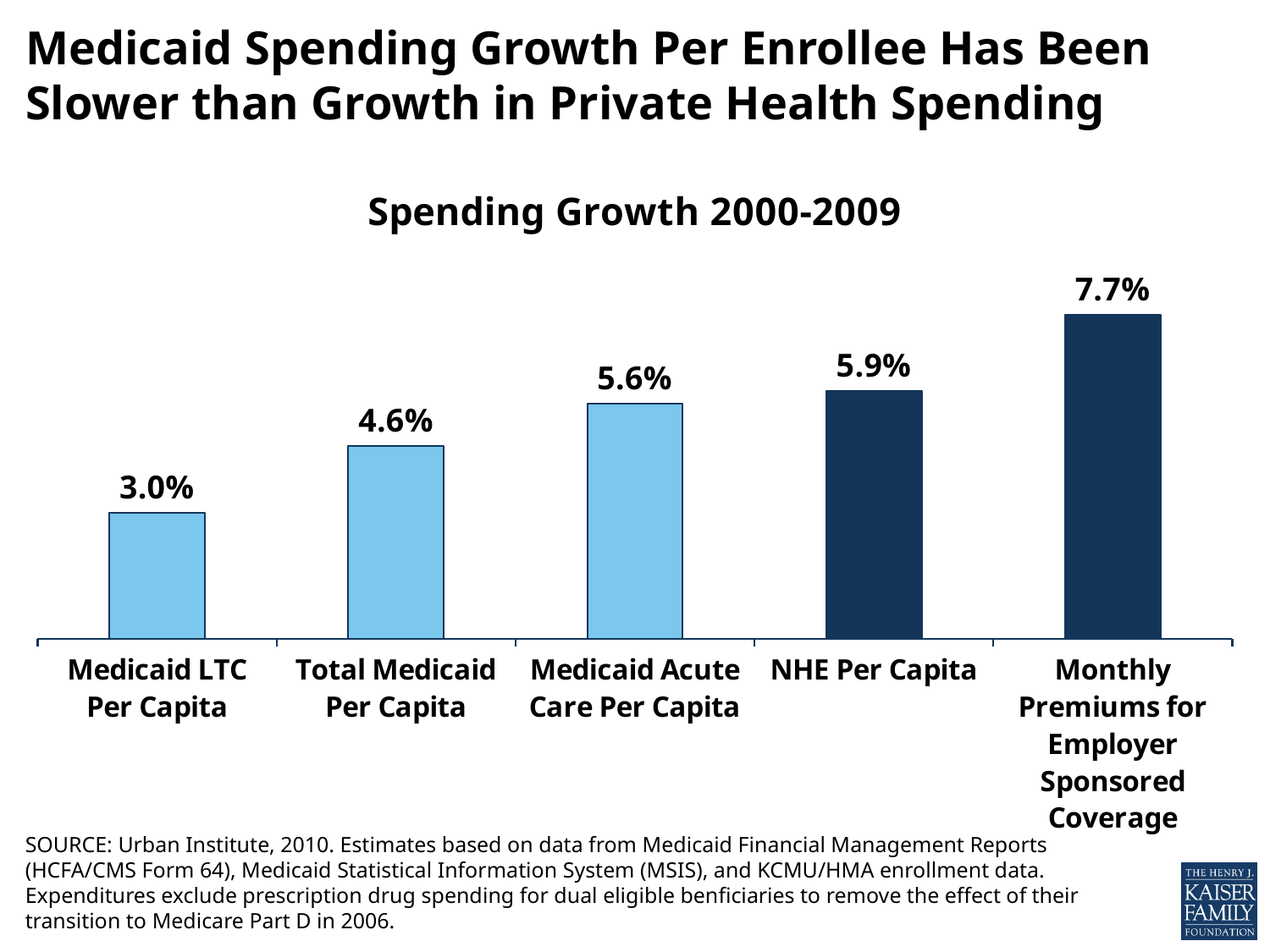
How many categories are shown in the chart? 5 What is the spending growth value for Monthly Premiums for Employer Sponsored Coverage? 7.7% Which is larger, the spending growth for Medicaid Acute Care Per Capita or Total Medicaid Per Capita? Medicaid Acute Care Per Capita What is the title of the chart? Spending Growth 2000-2009 What is the difference between the spending growth for NHE Per Capita and Medicaid Acute Care Per Capita? 0.3% Which category has the lowest spending growth? Medicaid LTC Per Capita What is the difference between the spending growth for Monthly Premiums for Employer Sponsored Coverage and Medicaid LTC Per Capita? 4.7% What kind of chart is shown on the slide? Bar chart Which category has the highest spending growth? Monthly Premiums for Employer Sponsored Coverage What is the spending growth value for NHE Per Capita? 5.9% What is the spending growth value for Medicaid LTC Per Capita? 3.0% What is the spending growth value for Total Medicaid Per Capita? 4.6%